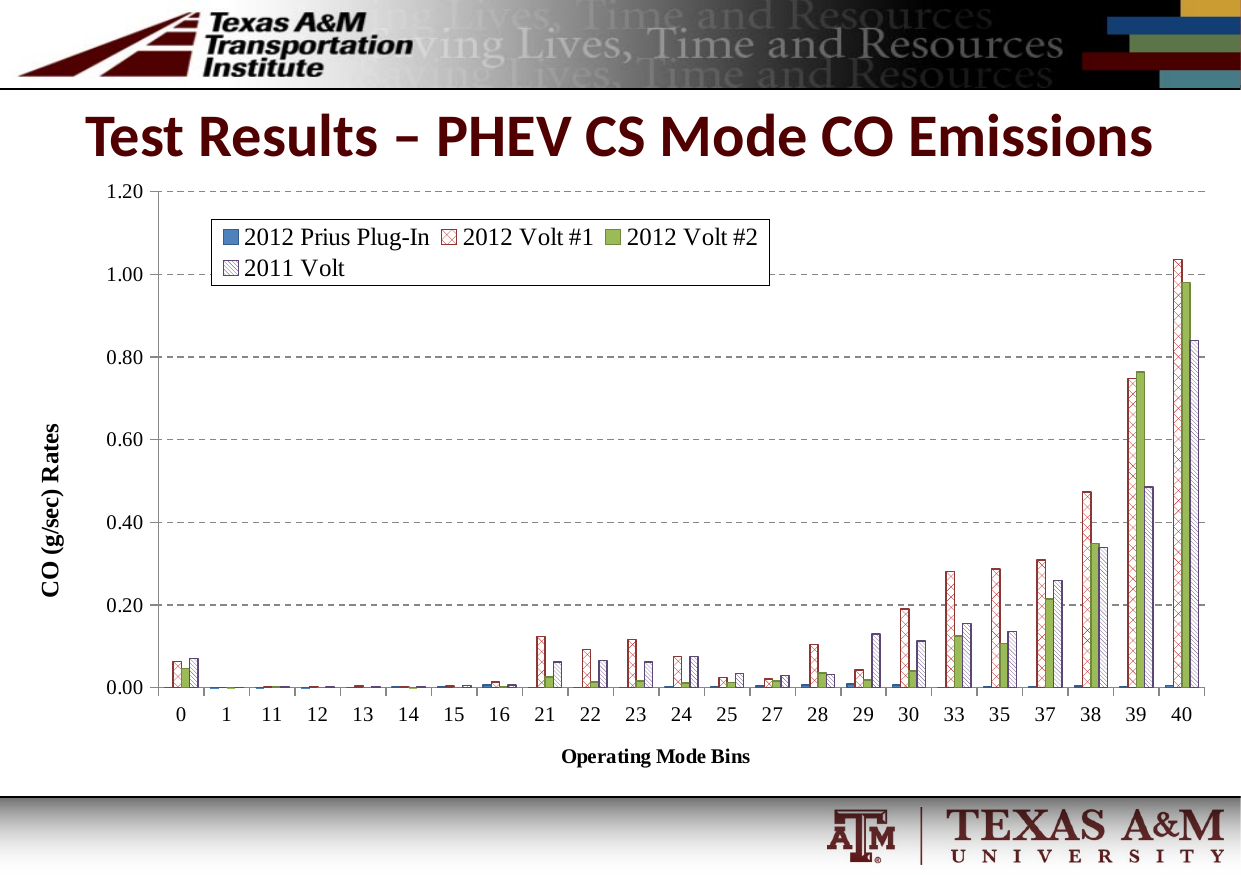
Which series has the lowest values across the operating mode bins? 2012 Prius Plug-In At bin 39, which is larger: 2012 Volt #2 or 2011 Volt? 2012 Volt #2 Is the value for 2012 Volt #1 at bin 38 greater or less than 0.40? greater What is the y-axis label of the chart? CO (g/sec) Rates How many operating mode bins are shown on the x axis? 23 Which operating mode bin has the highest value for 2012 Volt #1? 40 Is the value for 2012 Volt #1 at bin 39 greater or less than 0.80? less What kind of chart is shown on the slide? bar chart How many series does the legend list? 4 Is the value for 2012 Volt #2 at bin 38 greater or less than 0.40? less